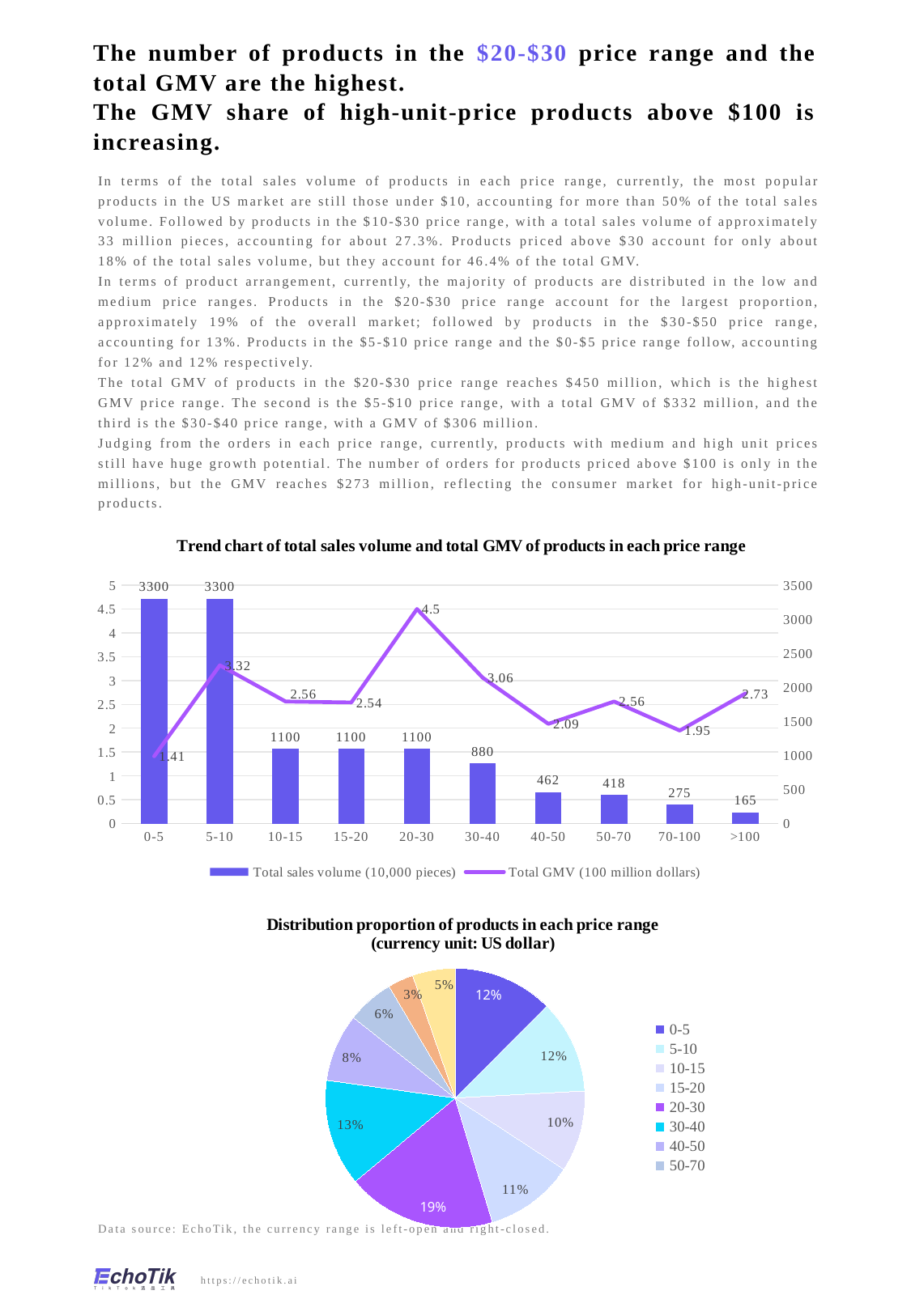
In the trend chart of total sales volume and total GMV, which price range has the highest total GMV? 20-30 In the pie chart of distribution proportion of products in each price range, what share does the 20-30 price range have? 19% In the trend chart of total sales volume and total GMV, what is the total GMV for the 20-30 price range? 4.5 In the trend chart of total sales volume and total GMV, how many series does the legend list? 2 In the trend chart of total sales volume and total GMV, how many price range categories are shown on the x axis? 10 What type of chart is the distribution proportion of products in each price range? pie chart In the trend chart of total sales volume and total GMV, what is the total sales volume for the 30-40 price range? 880 In the pie chart of distribution proportion of products in each price range, which price range listed in the legend has the smallest share? 50-70 In the trend chart of total sales volume and total GMV, which price range has the lowest total sales volume? >100 In the trend chart of total sales volume and total GMV, which has a higher total GMV, the 5-10 price range or the 30-40 price range? 5-10 In the trend chart of total sales volume and total GMV, what is the difference in total sales volume between the 40-50 and 50-70 price ranges? 44 In the trend chart of total sales volume and total GMV, does the total sales volume generally rise or fall from the 0-5 range to the >100 range? fall